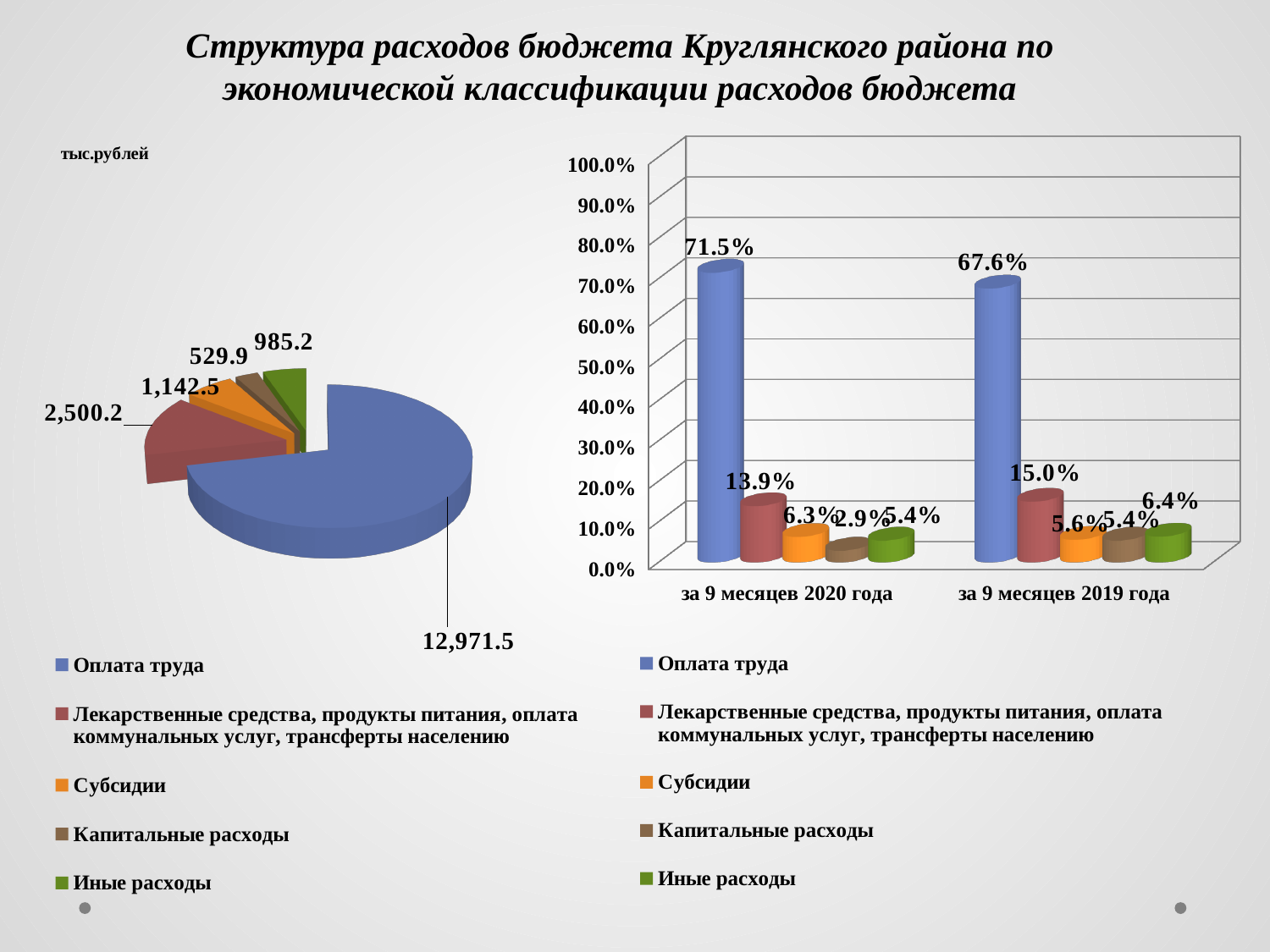
On the bar chart on the right, what is the value for Капитальные расходы for за 9 месяцев 2019 года? 5.4% What kind of chart is shown on the right side of the slide? Bar chart On the pie chart on the left, what is the value for Капитальные расходы? 529.9 On the pie chart on the left, which category has the smallest value? Капитальные расходы On the pie chart on the left, what is the value for Оплата труда? 12,971.5 On the bar chart on the right, which is larger for Субсидии: за 9 месяцев 2020 года or за 9 месяцев 2019 года? за 9 месяцев 2020 года On the bar chart on the right, what is the difference between the Оплата труда values for за 9 месяцев 2020 года and за 9 месяцев 2019 года? 3.9% On the bar chart on the right, how many series does the legend list? 5 On the pie chart on the left, what is the difference between the values for Субсидии and Иные расходы? 157.3 On the pie chart on the left, how many slices are there? 5 On the bar chart on the right, what is the value for Оплата труда for за 9 месяцев 2020 года? 71.5% What unit is indicated above the pie chart on the left? тыс.рублей